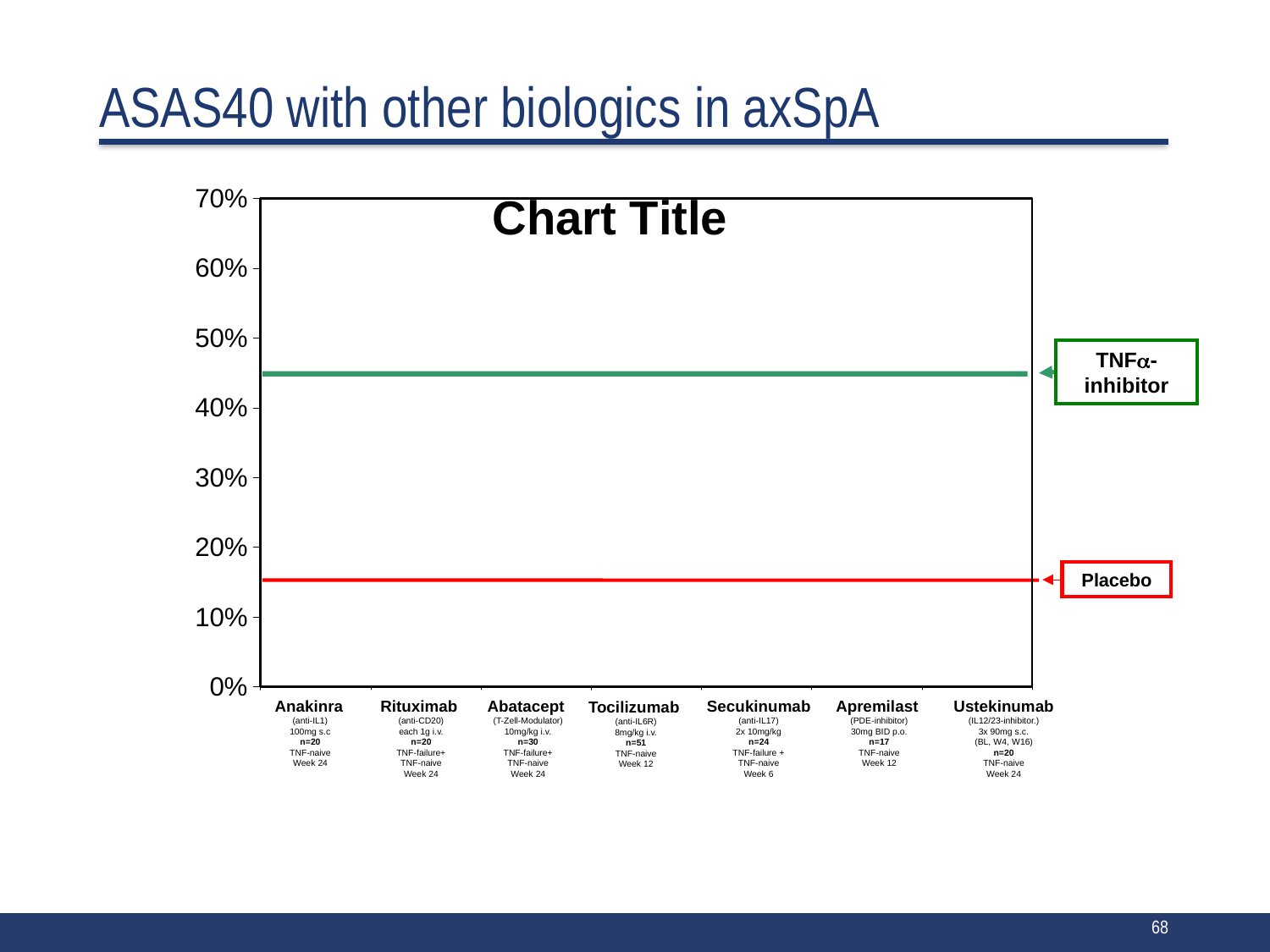
What is the sample size (n) given for Apremilast on the x axis label? n=17 Is the TNFα-inhibitor reference line greater or less than 40%? greater Is the Placebo reference line greater or less than 10%? greater Which drug on the x axis is labelled as anti-IL17? Secukinumab What is the highest value shown on the y axis of the chart? 70% What colour is the Placebo reference line on the chart? Red Is the TNFα-inhibitor reference line greater or less than 50%? less What is the sample size (n) given for Tocilizumab on the x axis label? n=51 How many drug categories are listed along the x axis of the chart? 7 At which week is the Secukinumab result reported according to its x axis label? Week 6 Which reference line is higher on the chart, TNFα-inhibitor or Placebo? TNFα-inhibitor